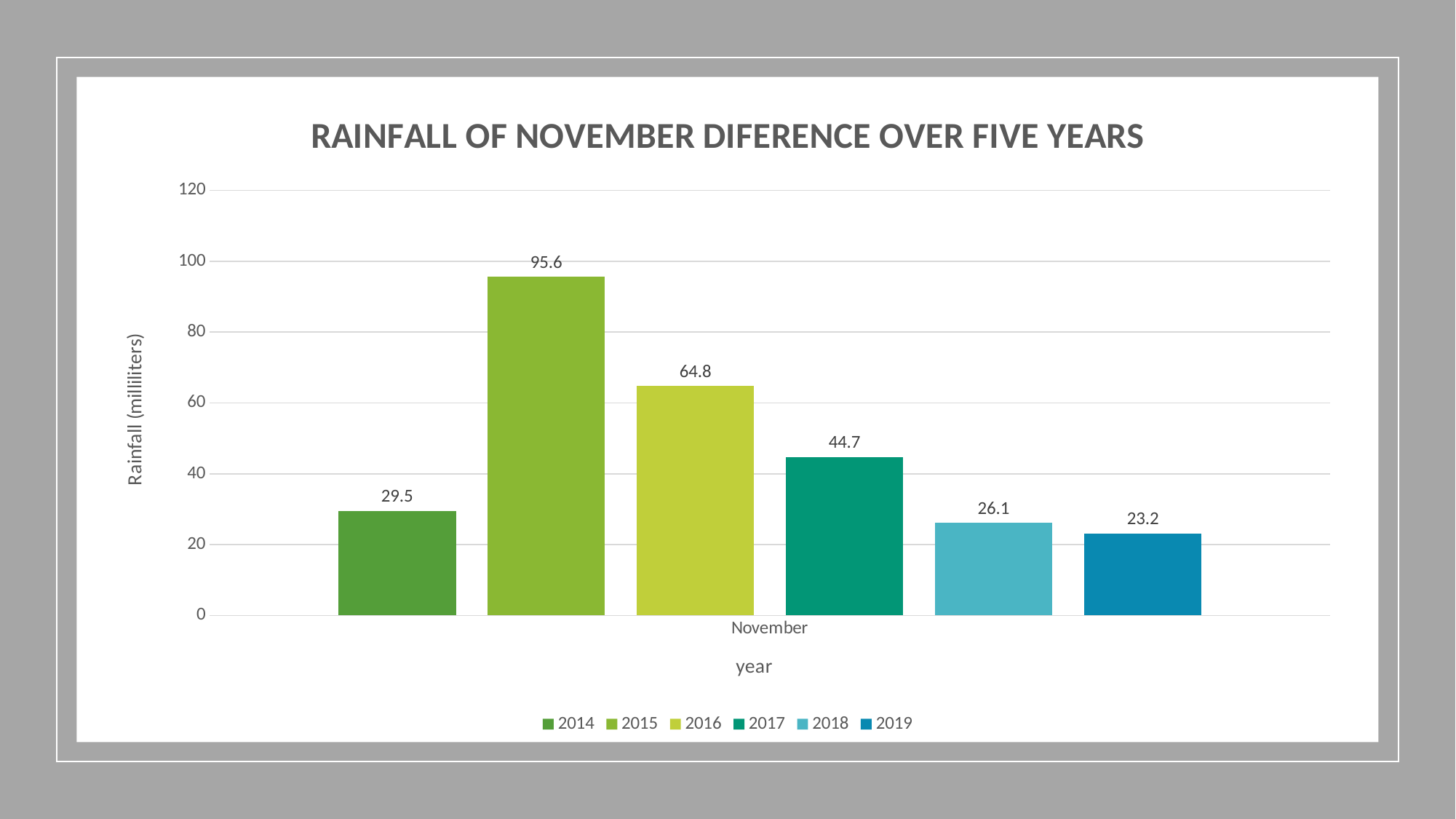
What is the rainfall value for 2019? 23.2 What is the difference between the rainfall values for 2014 and 2018? 3.4 Which year has the lowest November rainfall? 2019 What is the difference between the rainfall values for 2015 and 2016? 30.8 Which year has the highest November rainfall? 2015 What kind of chart is shown on the slide? Bar chart What is the title of the chart? RAINFALL OF NOVEMBER DIFERENCE OVER FIVE YEARS What is the rainfall value for 2015? 95.6 What is the rainfall value for 2017? 44.7 Is the value for 2017 greater or less than 40? greater How many series does the legend list? 6 Which is larger, the rainfall for 2016 or for 2017? 2016